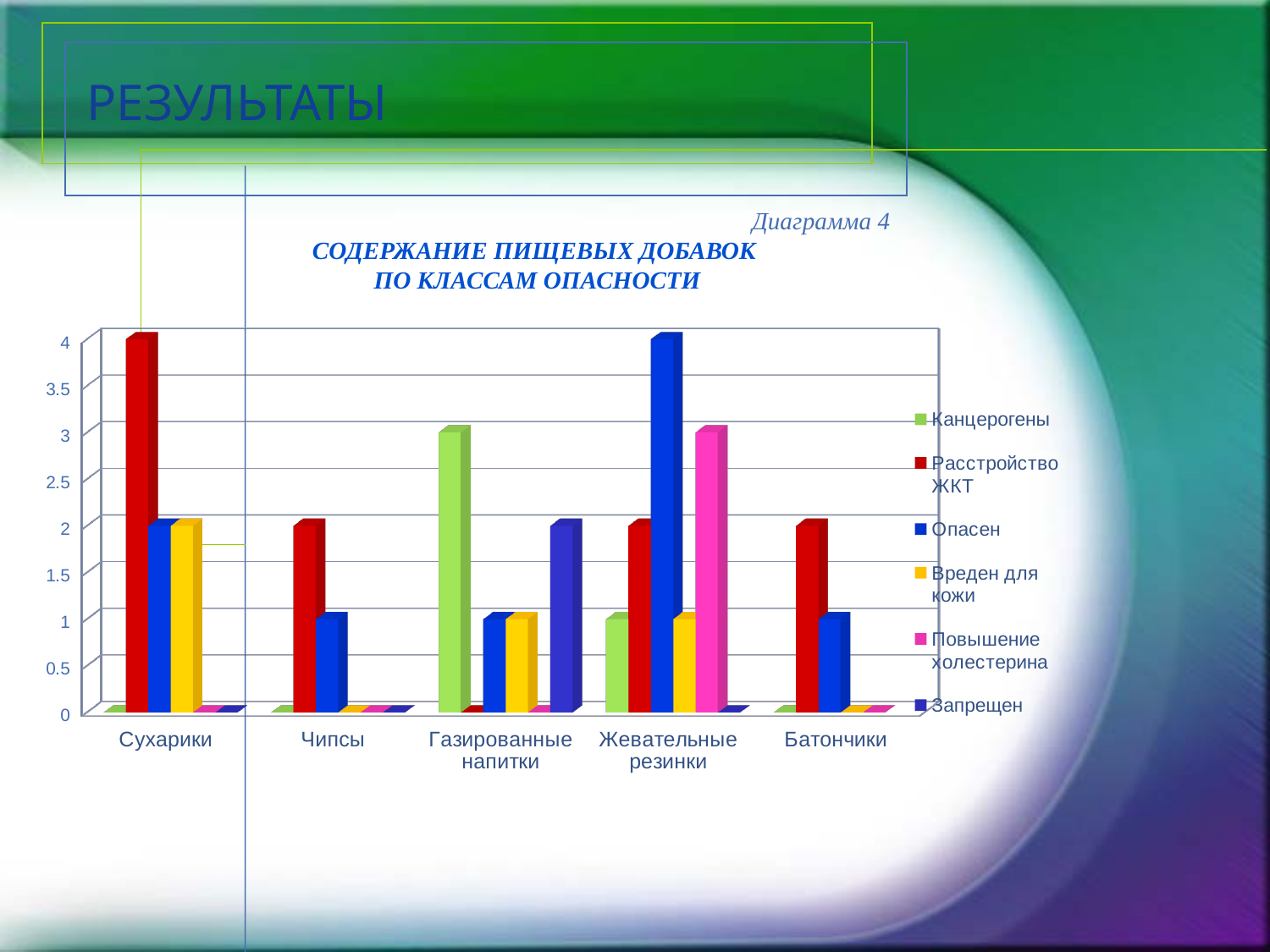
What is the value of Расстройство ЖКТ for Сухарики? 4 What is the value of Повышение холестерина for Жевательные резинки? 3 Which is larger: the Канцерогены value for Газированные напитки or the Канцерогены value for Жевательные резинки? Газированные напитки Which category has the highest value for Расстройство ЖКТ? Сухарики What is the value of Запрещен for Газированные напитки? 2 How many series does the legend list? 6 What is the difference between the Расстройство ЖКТ value for Сухарики and for Чипсы? 2 How many product categories are shown on the x axis? 5 What is the value of Канцерогены for Газированные напитки? 3 What kind of chart is shown on the slide? bar chart What is the value of Опасен for Жевательные резинки? 4 Which category has the highest value for Опасен? Жевательные резинки